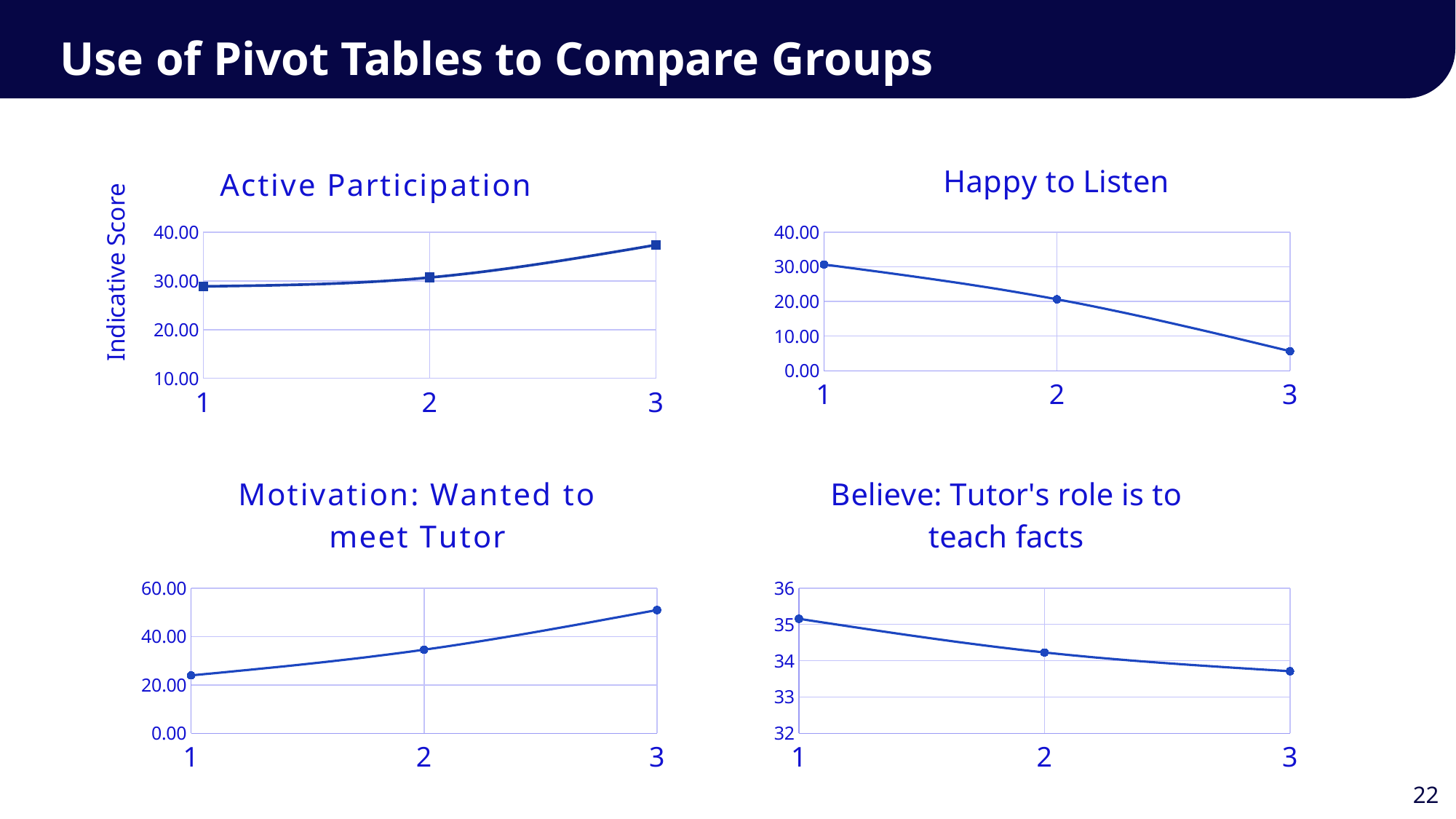
What is the y-axis label shown next to the "Active Participation" chart? Indicative Score On the "Active Participation" chart, do the values rise or fall from 1 to 3? rise On the "Believe: Tutor's role is to teach facts" chart, do the values rise or fall from 1 to 3? fall On the "Active Participation" chart, is the value for 3 greater or less than 30.00? greater What kind of chart is the "Active Participation" chart? line chart How many points are plotted on the "Happy to Listen" chart? 3 On the "Believe: Tutor's role is to teach facts" chart, is the value for 3 greater or less than 34? less On the "Happy to Listen" chart, which x-axis category has the lowest value? 3 On the "Happy to Listen" chart, do the values rise or fall from 1 to 3? fall On the "Motivation: Wanted to meet Tutor" chart, is the value for 3 greater or less than 40.00? greater